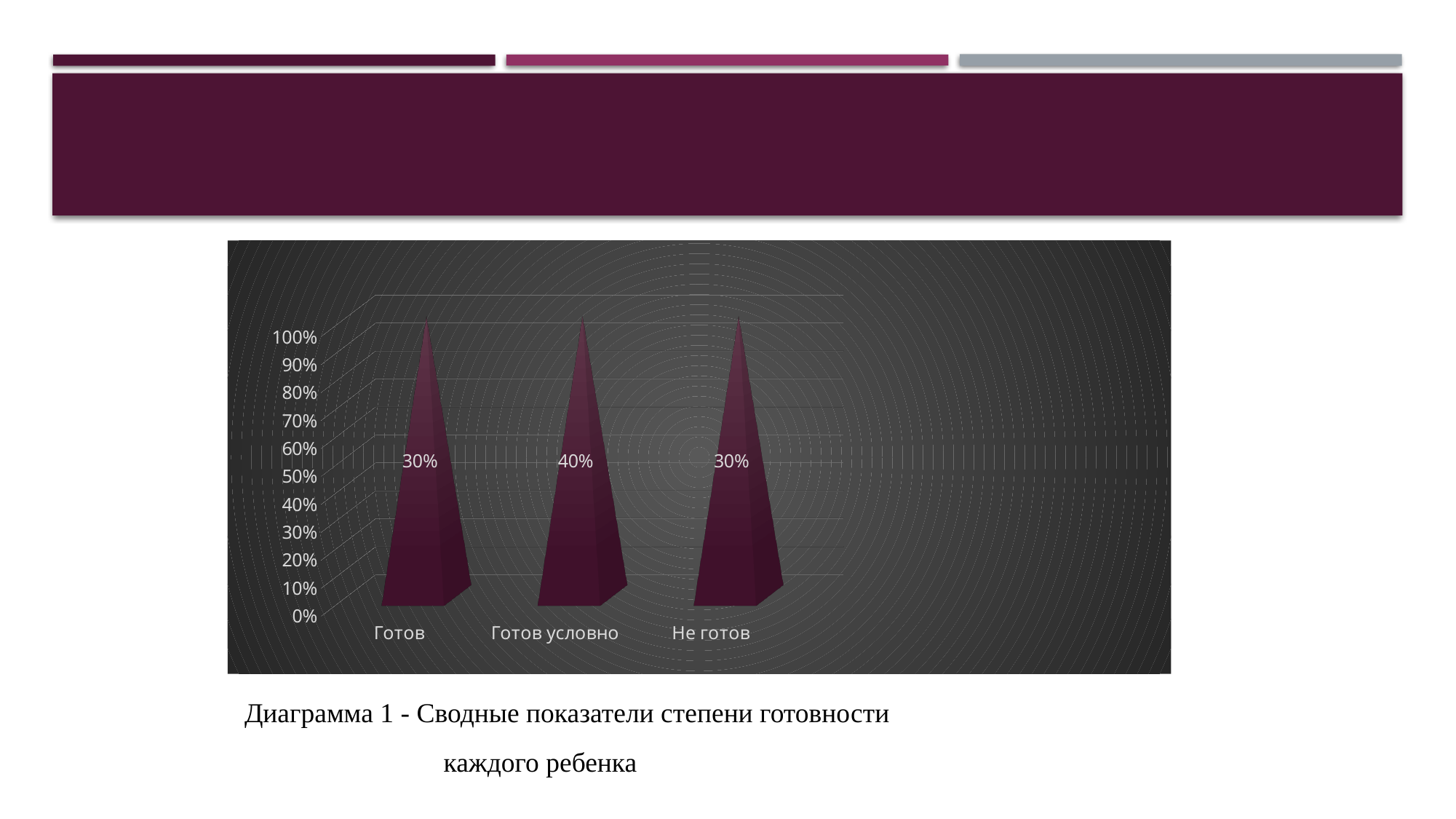
What is the highest tick label shown on the vertical axis? 100% Which category has the highest value? Готов условно What is the difference between the values for Готов условно and Готов? 10% What kind of chart is shown on the slide? bar chart What is the caption printed below the chart? Диаграмма 1 - Сводные показатели степени готовности каждого ребенка What is the value for Не готов? 30% What is the total of the three values shown in the chart? 100% What is the value for Готов? 30% Which is larger, the value for Готов условно or the value for Не готов? Готов условно How many categories are shown on the x axis? 3 What is the value for Готов условно? 40% What is the difference between the values for Готов условно and Не готов? 10%